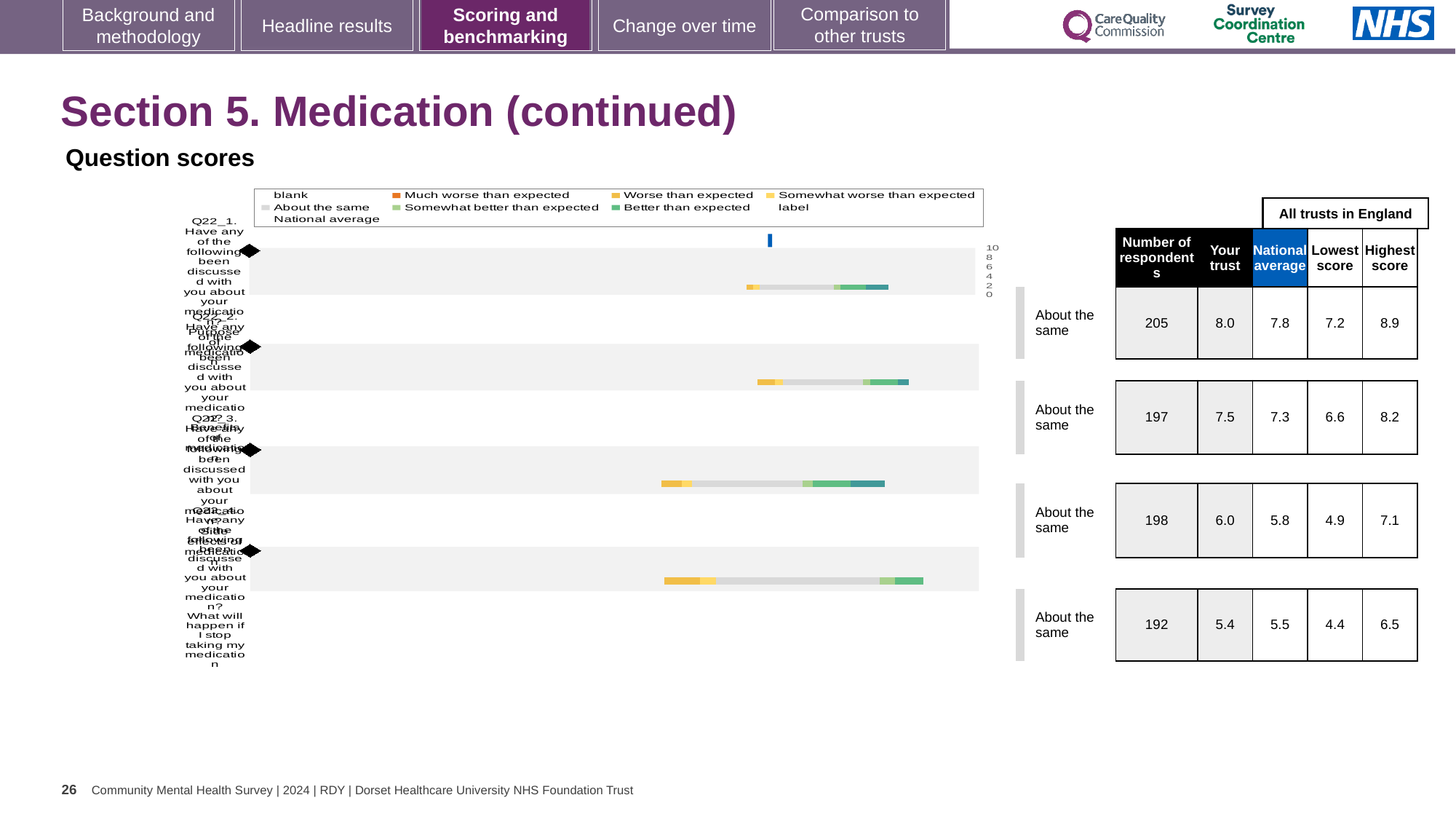
What kind of chart is shown on the slide? bar chart Which question row has the highest 'Your trust' score? the first (top) row, 8.0 In the table beside the chart, what is the 'Your trust' score for the first (top) question row? 8.0 How many question rows are plotted in the chart? 4 In the table beside the chart, how many respondents are listed for the third question row? 198 What colour does the legend use for 'Much worse than expected'? orange For the first (top) question row, what is the difference between the 'Your trust' score and the national average? 0.2 In the table beside the chart, what is the national average for the second question row? 7.3 In the table beside the chart, what is the highest score for the fourth (bottom) question row? 6.5 Which question row has the lowest 'Your trust' score? the fourth (bottom) row, 5.4 For the fourth (bottom) question row, which is larger: the 'Your trust' score or the national average? national average What benchmark category is shown for every question row in the chart? About the same